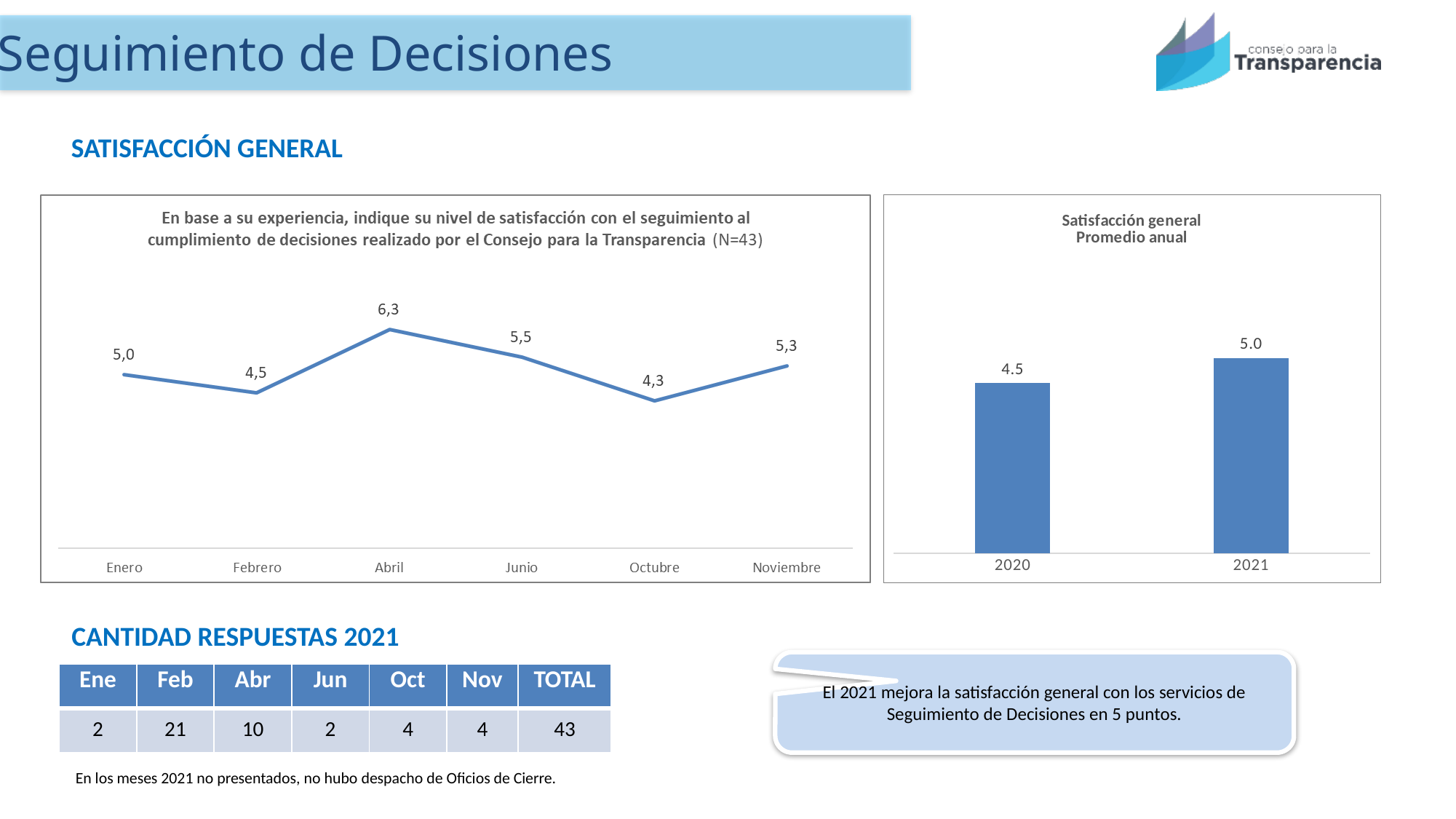
In the right chart 'Satisfacción general Promedio anual', do the values rise or fall from 2020 to 2021? Rise In the right chart 'Satisfacción general Promedio anual', what is the difference between the 2021 and 2020 values? 0.5 In the left chart (monthly satisfaction line chart), which month has the highest value? Abril What kind of chart is the left chart on the slide? Line chart In the left chart (monthly satisfaction line chart), how many months are plotted? 6 In the left chart (monthly satisfaction line chart), which month has the lowest value? Octubre What kind of chart is the right chart 'Satisfacción general Promedio anual'? Bar chart In the left chart (monthly satisfaction line chart), which is larger, the value for Enero or the value for Noviembre? Noviembre In the left chart (monthly satisfaction line chart), what is the value for Octubre? 4,3 In the left chart (monthly satisfaction line chart), what is the value for Abril? 6,3 In the right chart 'Satisfacción general Promedio anual', what is the value for 2021? 5.0 In the left chart (monthly satisfaction line chart), what is the difference between the values for Abril and Febrero? 1,8